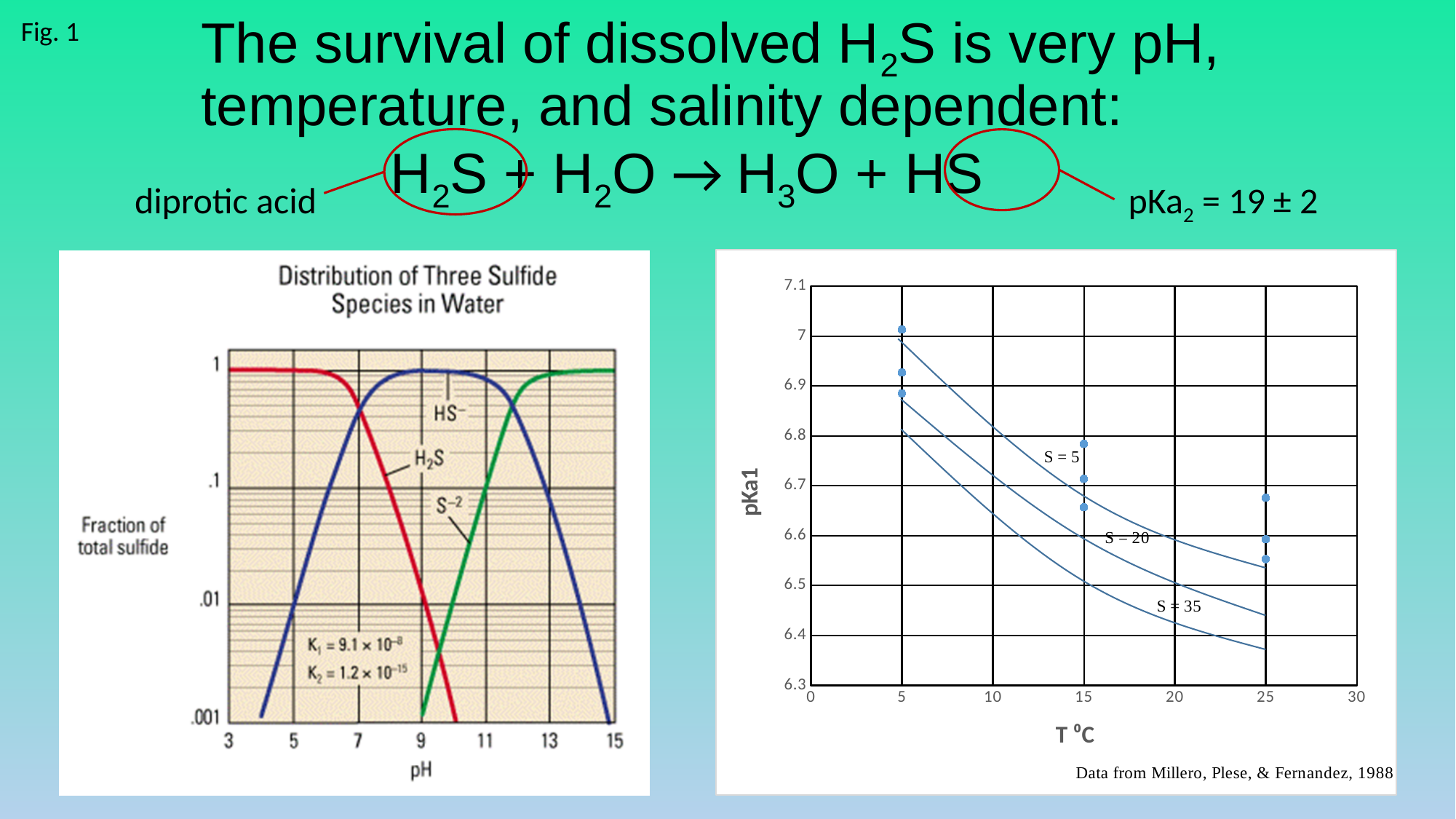
In the left chart, 'Distribution of Three Sulfide Species in Water', which species has the highest fraction at pH 15? S-2 In the right chart of pKa1 versus T °C, at 15 °C is pKa1 larger for S = 5 or for S = 35? S = 5 What kind of chart is the left chart, 'Distribution of Three Sulfide Species in Water'? Line chart In the right chart of pKa1 versus T °C, what is the label of the y axis? pKa1 In the right chart of pKa1 versus T °C, how many salinity curves are drawn? 3 In the left chart, 'Distribution of Three Sulfide Species in Water', what value of K1 is printed on the chart? 9.1 × 10⁻⁸ In the left chart, 'Distribution of Three Sulfide Species in Water', does the fraction of H2S rise or fall as pH increases? Fall In the left chart, 'Distribution of Three Sulfide Species in Water', what is the label of the x axis? pH In the right chart of pKa1 versus T °C, which salinity curve has the lowest pKa1 values? S = 35 In the left chart, 'Distribution of Three Sulfide Species in Water', how many sulfide species are plotted? 3 In the right chart of pKa1 versus T °C, does pKa1 rise or fall as temperature increases? Fall In the left chart, 'Distribution of Three Sulfide Species in Water', what value of K2 is printed on the chart? 1.2 × 10⁻¹⁵